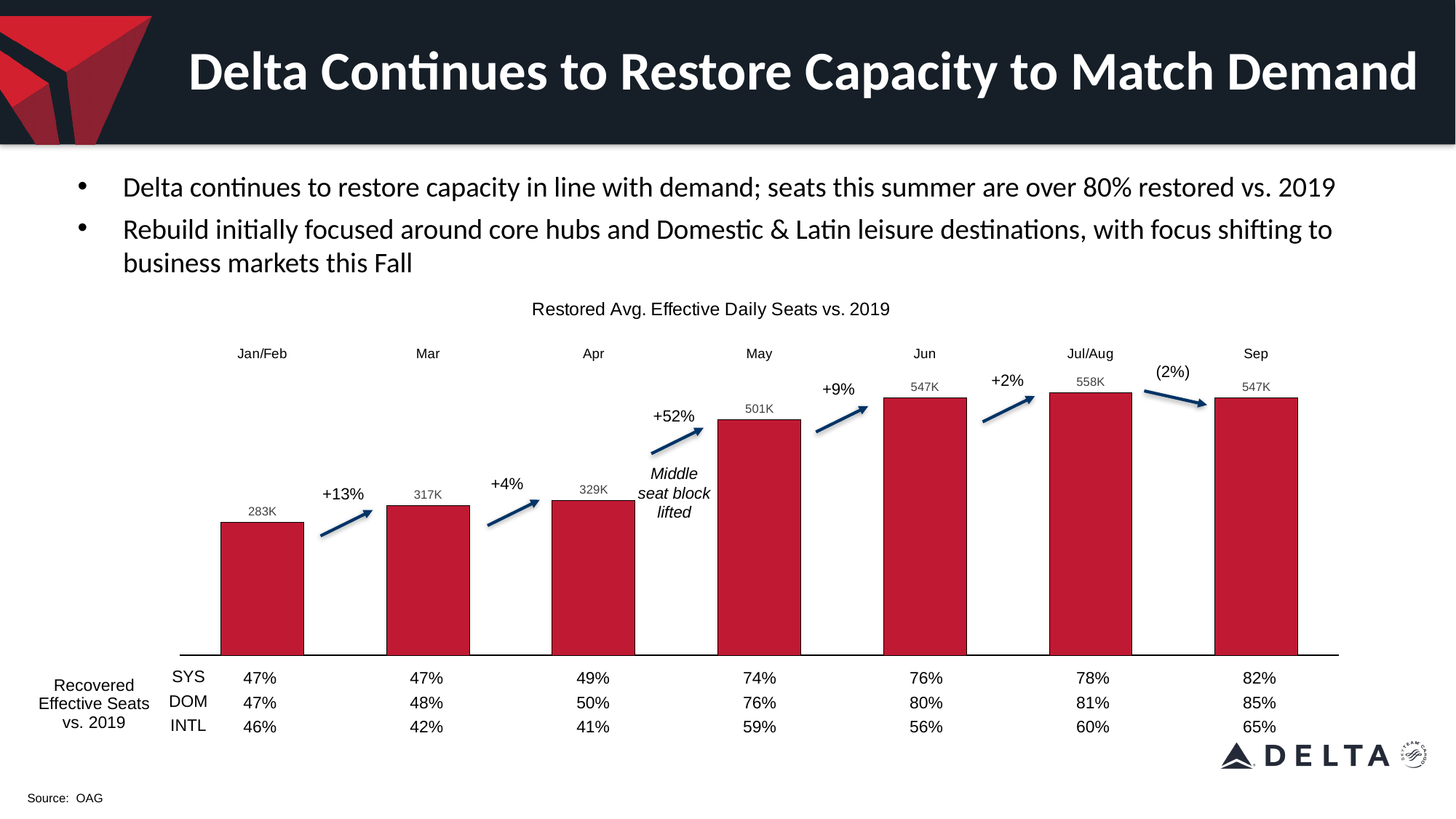
What is the difference between the Jul/Aug value and the Sep value? 11K Which is larger, the value for Apr or the value for May? May Which month has the highest value in the chart? Jul/Aug What is the title of the chart? Restored Avg. Effective Daily Seats vs. 2019 What is the SYS recovered effective seats vs. 2019 percentage for Sep? 82% Which month has the lowest value in the chart? Jan/Feb What is the value for May in the Restored Avg. Effective Daily Seats vs. 2019 chart? 501K What is the value for Jan/Feb in the chart? 283K What percentage change is labeled on the arrow between Apr and May? +52% Do the values generally rise or fall from Jan/Feb to Jul/Aug? Rise How many months or month groups are shown on the x axis of the chart? 7 What kind of chart is shown on the slide? Bar chart